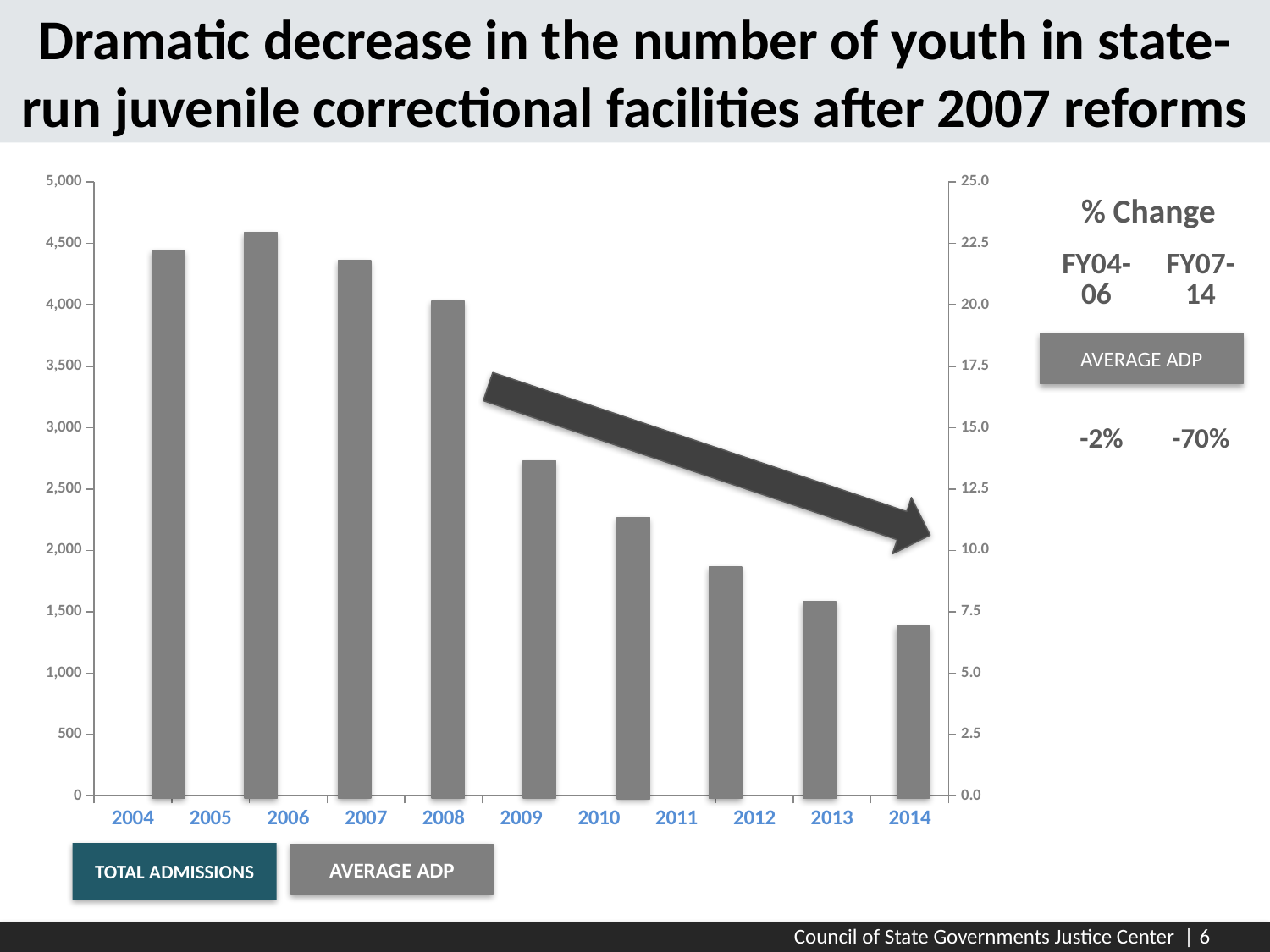
What kind of chart is shown on the slide? bar chart Which year has the tallest bar in the chart? 2005 How many series does the legend below the chart list? 2 What are the two legend entries shown below the chart? TOTAL ADMISSIONS and AVERAGE ADP Do the bars generally rise or fall from 2008 to 2014? fall How many years are shown on the x axis of the chart? 11 What is the % Change in Average ADP shown for FY07-14? -70% Which year has the shortest bar in the chart? 2014 Is the value for 2004 greater or less than 4,000 on the left axis? greater Which bar is taller, 2009 or 2010? 2009